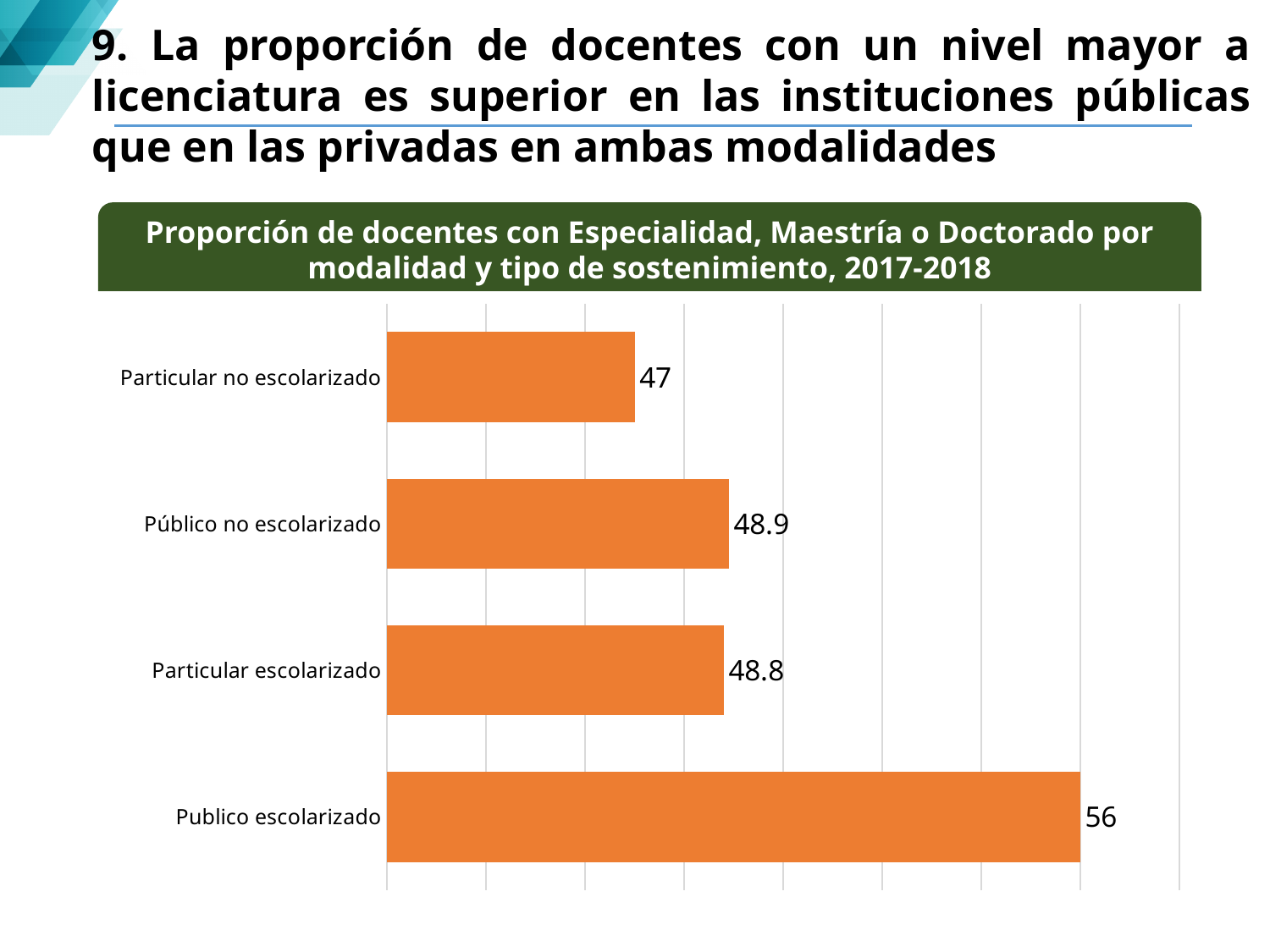
What is the title of the chart? Proporción de docentes con Especialidad, Maestría o Doctorado por modalidad y tipo de sostenimiento, 2017-2018 Which category has the lowest value? Particular no escolarizado What is the value for Público no escolarizado? 48.9 What is the value for Publico escolarizado? 56 What is the value for Particular escolarizado? 48.8 What is the difference between the values for Publico escolarizado and Particular escolarizado? 7.2 How many categories are shown in the chart? 4 What type of chart is shown on the slide? bar chart Which category has the highest value? Publico escolarizado Which is larger, the value for Publico escolarizado or the value for Público no escolarizado? Publico escolarizado What is the value for Particular no escolarizado? 47 What is the difference between the values for Público no escolarizado and Particular no escolarizado? 1.9